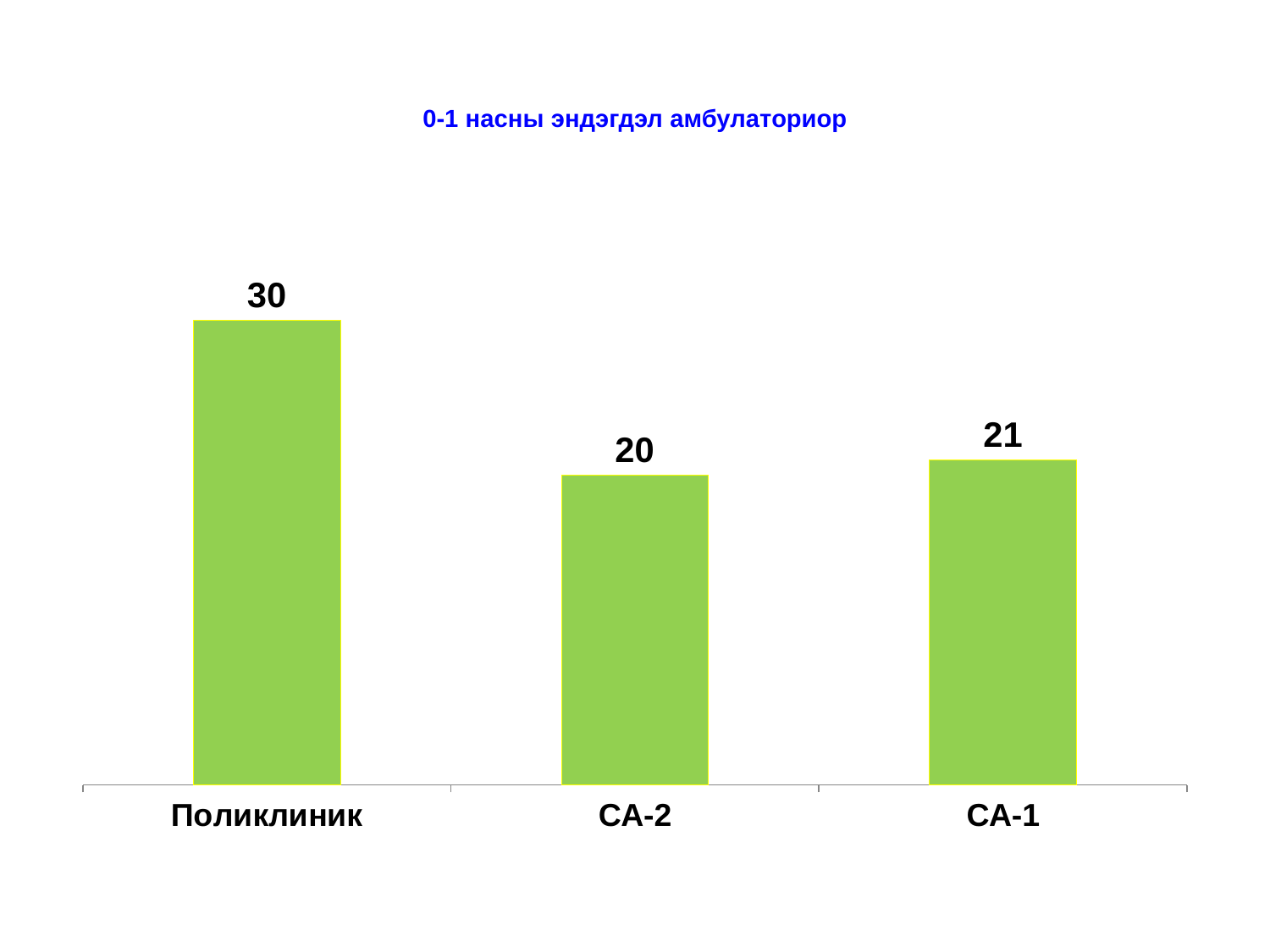
What colour are the bars in the chart? Green What is the value for Поликлиник? 30 Which is larger, the value for Поликлиник or the value for СА-1? Поликлиник What is the difference between the values for СА-1 and СА-2? 1 What is the difference between the values for Поликлиник and СА-2? 10 What kind of chart is shown on the slide? Bar chart What is the value for СА-1? 21 Which category has the highest value? Поликлиник Which category has the lowest value? СА-2 What is the title of the chart? 0-1 насны эндэгдэл амбулаториор How many categories are shown on the chart? 3 What is the value for СА-2? 20